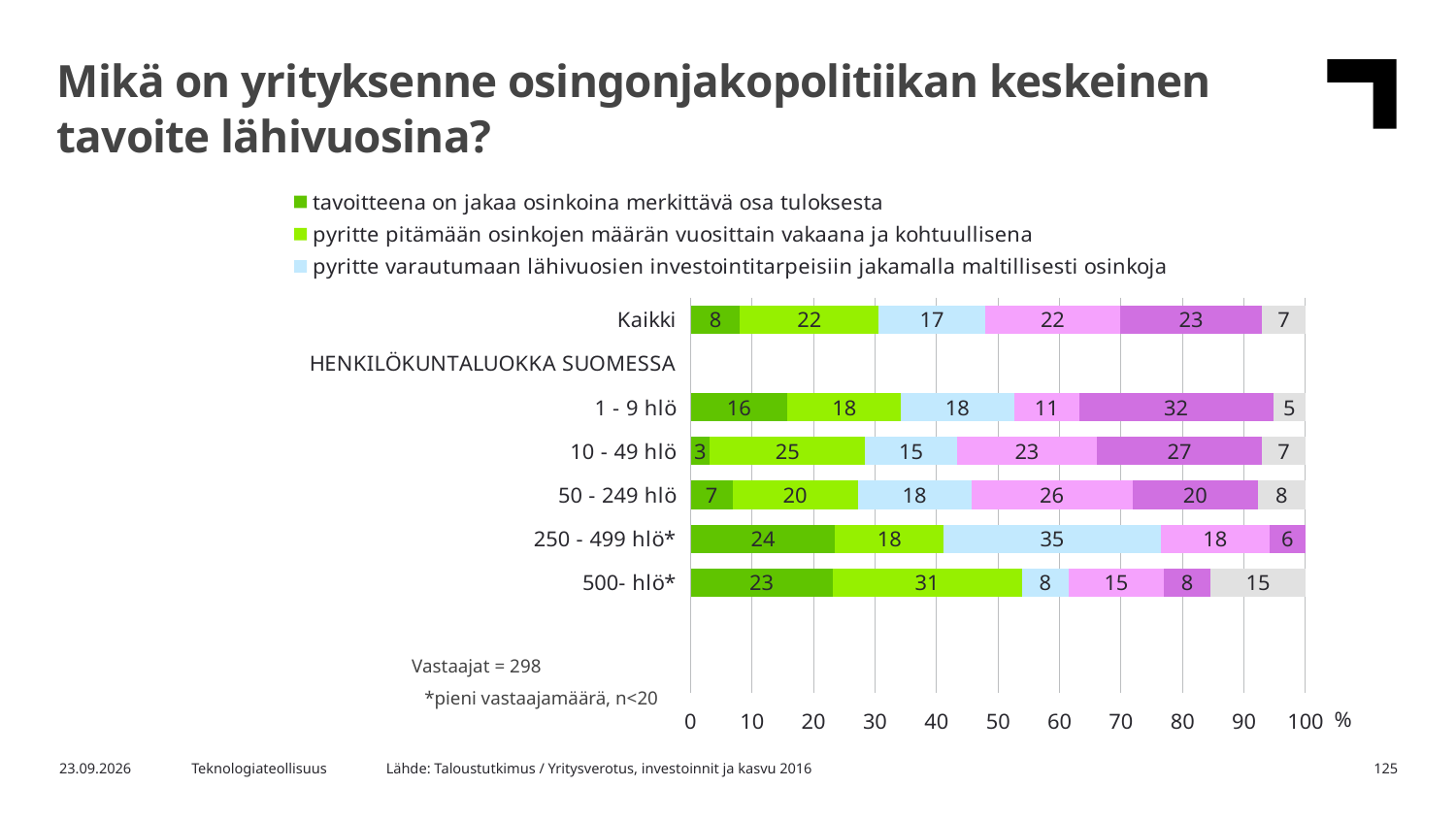
What is the value of 'pyritte varautumaan lähivuosien investointitarpeisiin jakamalla maltillisesti osinkoja' for 250 - 499 hlö*? 35 What is the value of 'pyritte pitämään osinkojen määrän vuosittain vakaana ja kohtuullisena' for 10 - 49 hlö? 25 How many series does the legend list? 3 Which has the larger value for 'tavoitteena on jakaa osinkoina merkittävä osa tuloksesta': 1 - 9 hlö or 50 - 249 hlö? 1 - 9 hlö What is the value of 'tavoitteena on jakaa osinkoina merkittävä osa tuloksesta' for Kaikki? 8 For Kaikki, what is the difference between 'pyritte pitämään osinkojen määrän vuosittain vakaana ja kohtuullisena' and 'tavoitteena on jakaa osinkoina merkittävä osa tuloksesta'? 14 Which category has the highest value for 'pyritte varautumaan lähivuosien investointitarpeisiin jakamalla maltillisesti osinkoja'? 250 - 499 hlö* What type of chart is shown on the slide? Stacked bar chart What is the value of 'pyritte pitämään osinkojen määrän vuosittain vakaana ja kohtuullisena' for 500- hlö*? 31 Which category has the lowest value for 'tavoitteena on jakaa osinkoina merkittävä osa tuloksesta'? 10 - 49 hlö What is the total of all segments in the 1 - 9 hlö bar? 100 How many categories have bars in the chart? 6